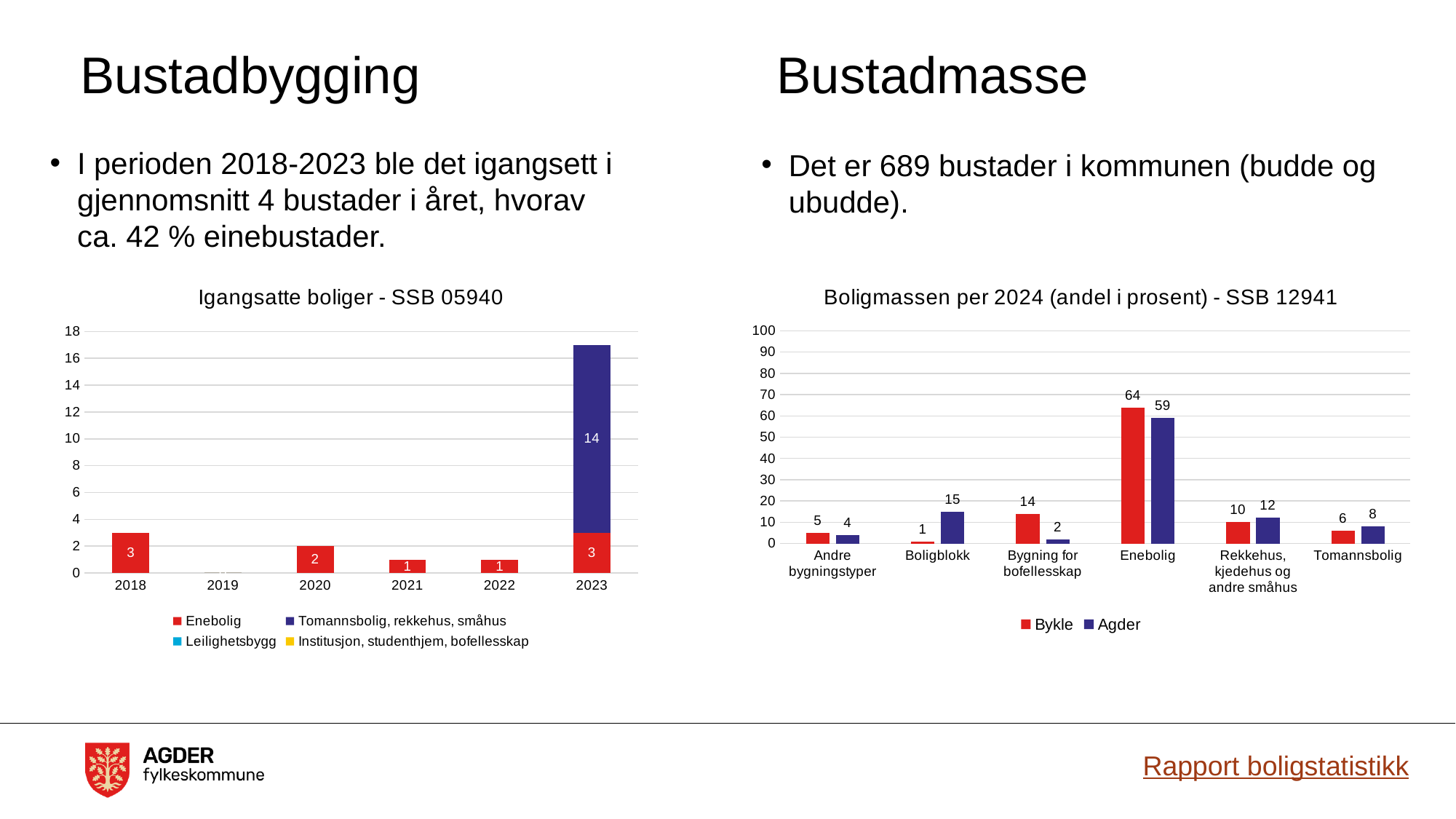
What kind of chart is 'Igangsatte boliger - SSB 05940'? Stacked bar chart In the chart 'Boligmassen per 2024 (andel i prosent) - SSB 12941', what is the difference between the Bykle and Agder values for Bygning for bofellesskap? 12 In the chart 'Boligmassen per 2024 (andel i prosent) - SSB 12941', what is the Bykle value for Enebolig? 64 In the chart 'Igangsatte boliger - SSB 05940', what is the Enebolig value for 2018? 3 In the chart 'Boligmassen per 2024 (andel i prosent) - SSB 12941', how many categories are shown on the x axis? 6 In the chart 'Igangsatte boliger - SSB 05940', how many series does the legend list? 4 In the chart 'Igangsatte boliger - SSB 05940', which year has the highest total? 2023 In the chart 'Boligmassen per 2024 (andel i prosent) - SSB 12941', which is larger for Rekkehus, kjedehus og andre småhus: Bykle or Agder? Agder In the chart 'Igangsatte boliger - SSB 05940', what is the value for Tomannsbolig, rekkehus, småhus in 2023? 14 In the chart 'Boligmassen per 2024 (andel i prosent) - SSB 12941', what is the Agder value for Boligblokk? 15 In the chart 'Boligmassen per 2024 (andel i prosent) - SSB 12941', which category has the lowest Bykle value? Boligblokk In the chart 'Igangsatte boliger - SSB 05940', what is the total of the stacked bar for 2023? 17